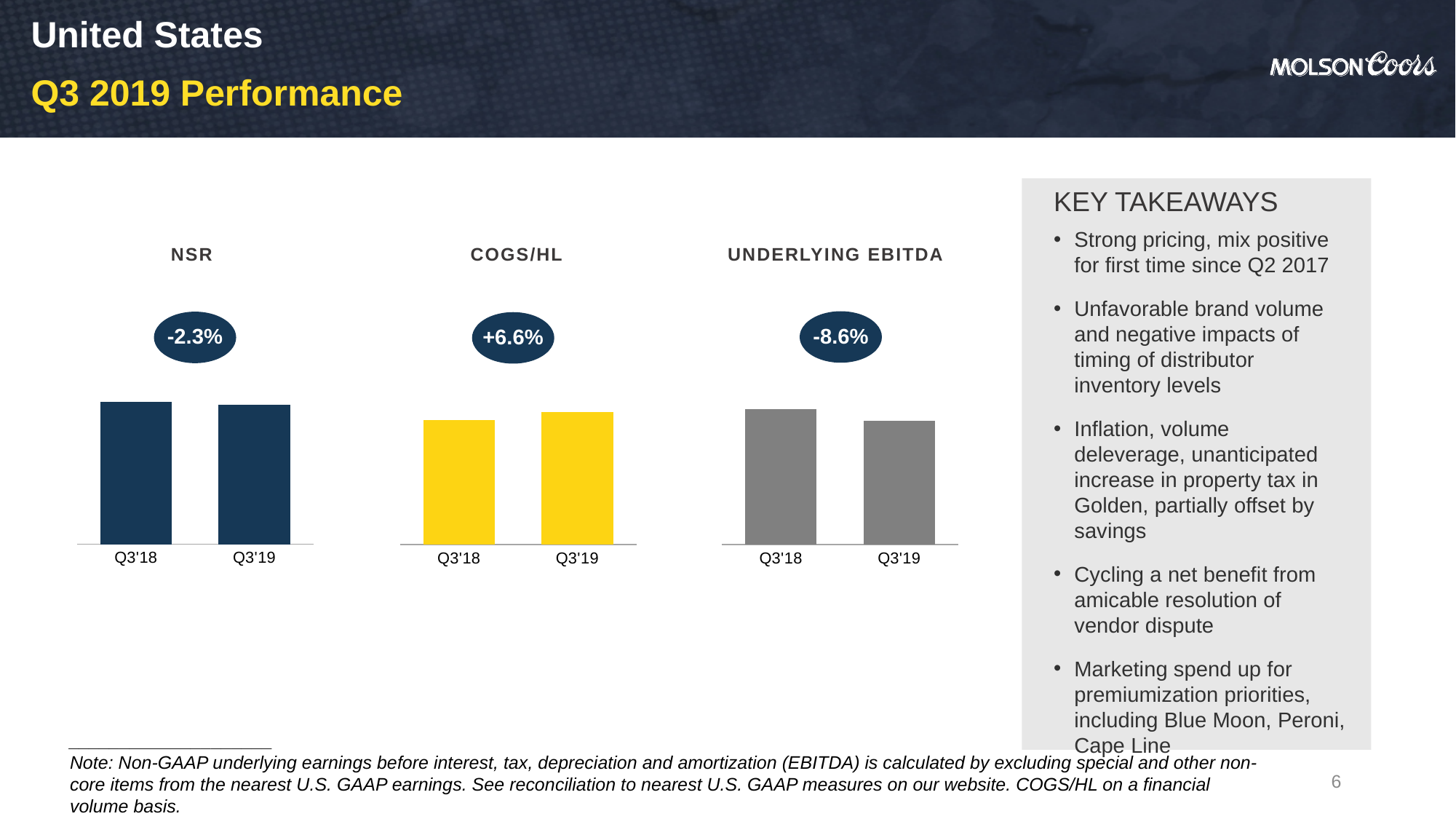
On the Underlying EBITDA chart, which bar is shorter, Q3'18 or Q3'19? Q3'19 On the Underlying EBITDA chart, what percentage change is shown in the oval label? -8.6% On the Underlying EBITDA chart, do the values rise or fall from Q3'18 to Q3'19? fall How many separate charts are shown on the slide? 3 What kind of chart is the Underlying EBITDA chart? bar chart On the COGS/HL chart, which bar is taller, Q3'18 or Q3'19? Q3'19 On the COGS/HL chart, what percentage change is shown in the oval label? +6.6% What colour are the bars on the COGS/HL chart? yellow On the COGS/HL chart, do the values rise or fall from Q3'18 to Q3'19? rise How many bars does the NSR chart have? 2 On the NSR chart, which bar is taller, Q3'18 or Q3'19? Q3'18 On the NSR chart, what percentage change is shown in the oval label? -2.3%